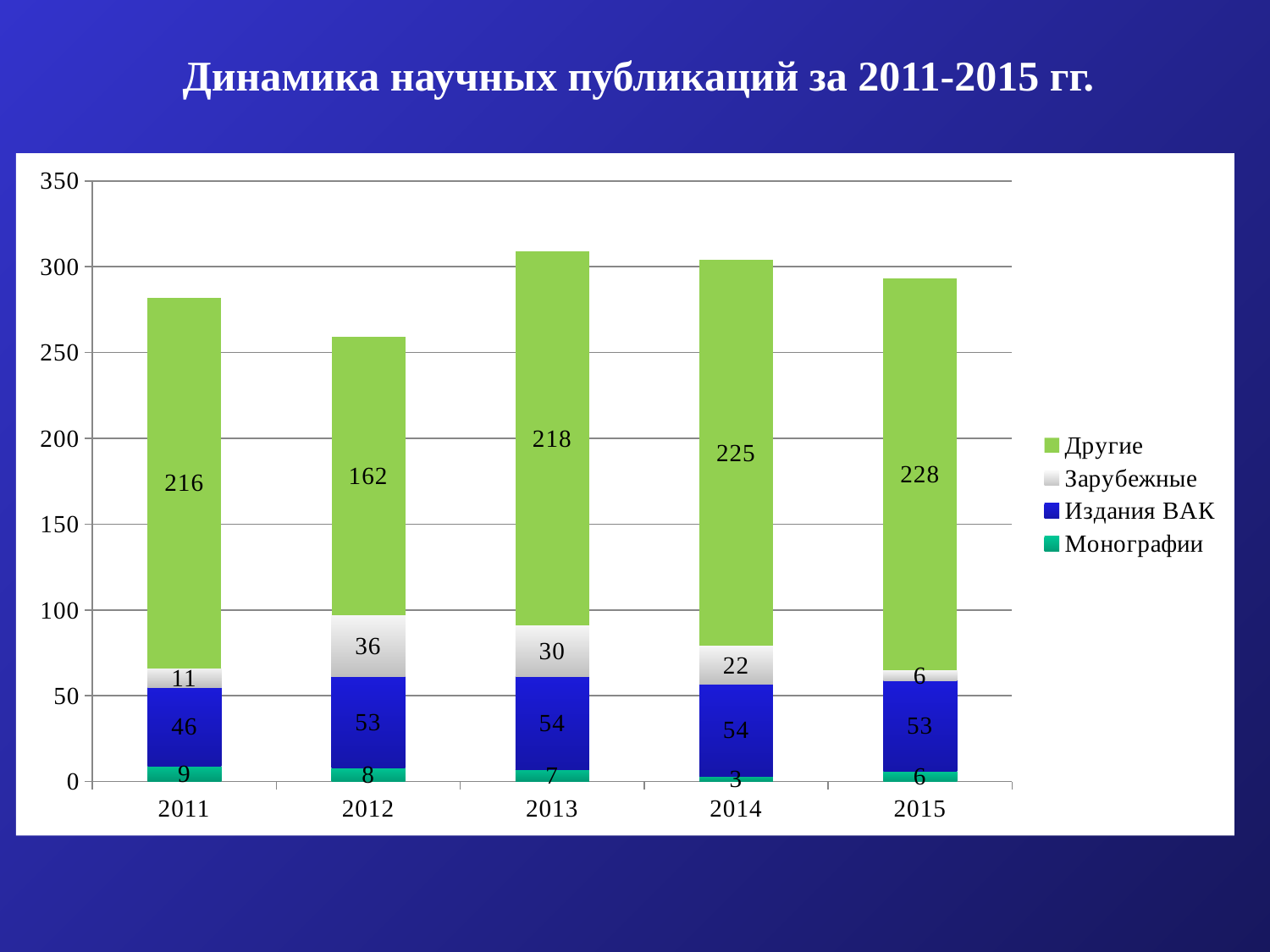
What is the value for Зарубежные in 2012? 36 Is the total of the stacked bar for 2013 greater or less than 300? greater What is the value for Другие in 2013? 218 What is the value for Монографии in 2014? 3 Which is larger, the Издания ВАК value for 2011 or for 2013? 2013 In which year is the value for Зарубежные the lowest? 2015 What type of chart is shown on the slide? Stacked bar chart In which year is the value for Другие the highest? 2015 How many series does the legend list? 4 How many years are shown on the x axis? 5 What is the difference between the Другие values for 2015 and 2012? 66 What is the total of the stacked bar for 2011? 282